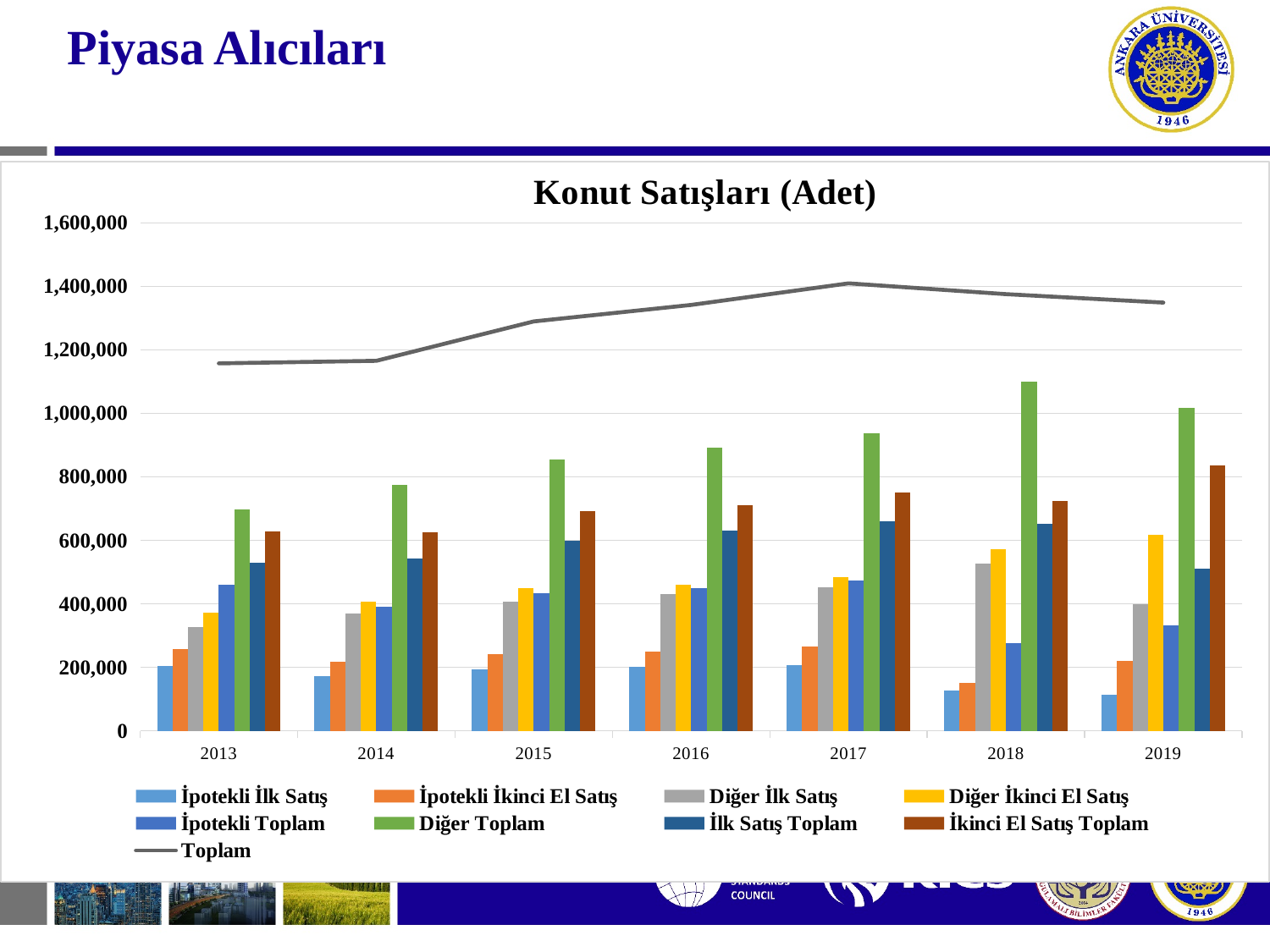
Which series is drawn as a line rather than bars? Toplam In which year does the Toplam line reach its highest point? 2017 How many series does the chart's legend list? 9 Is the Toplam value in 2013 greater or less than 1,200,000? less Is the value for İkinci El Satış Toplam in 2019 greater or less than 800,000? greater How many years are shown on the x axis of the chart? 7 In which year is the Diğer Toplam bar the highest? 2018 Which is larger in 2019: İlk Satış Toplam or İkinci El Satış Toplam? İkinci El Satış Toplam Is the value for Diğer Toplam in 2018 greater or less than 1,000,000? greater Does the Toplam line rise or fall from 2013 to 2017? rise What kind of chart is shown on the slide? bar and line chart What is the title of the chart? Konut Satışları (Adet)